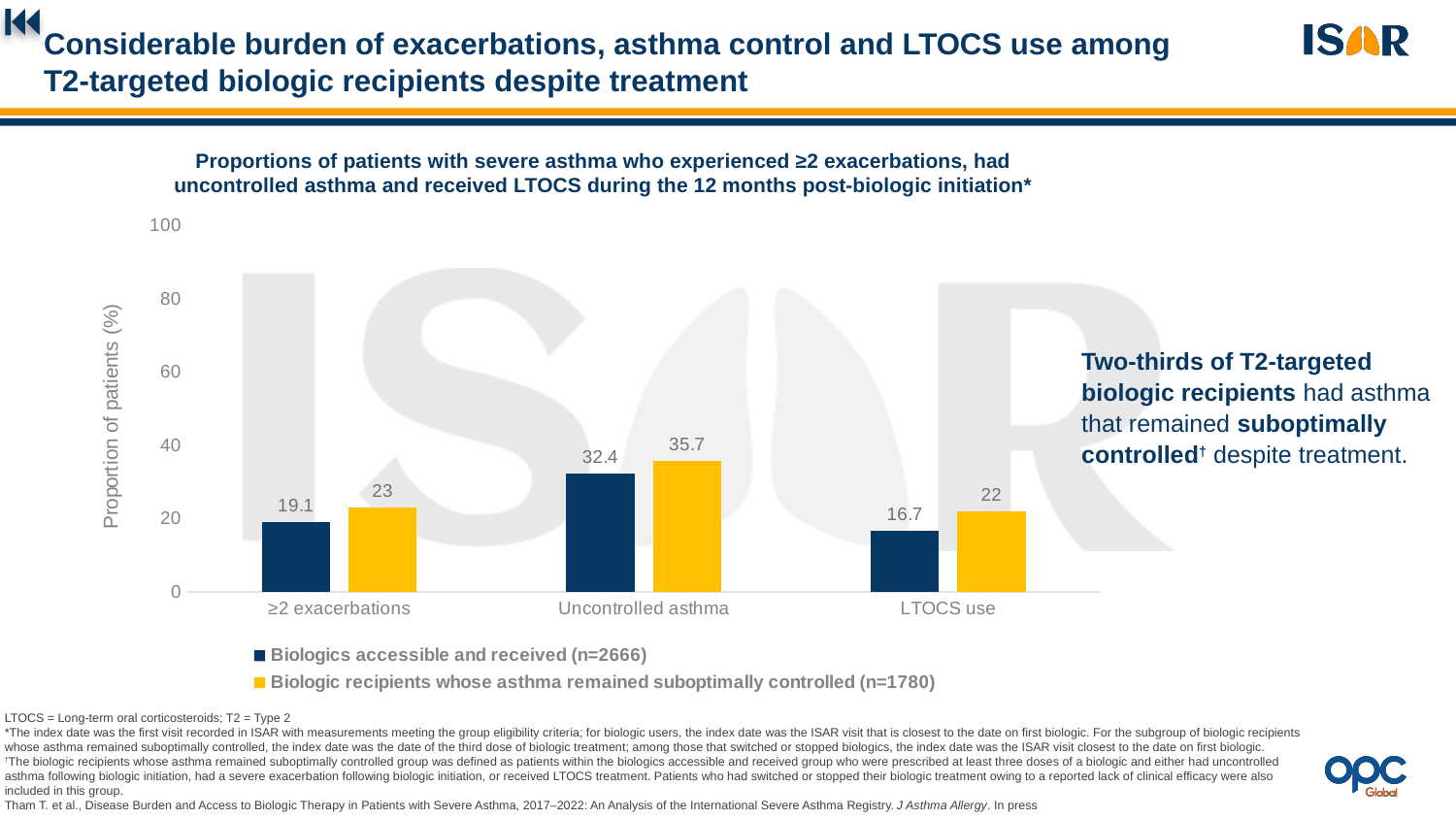
Which category has the highest value in the 'Biologic recipients whose asthma remained suboptimally controlled (n=1780)' series? Uncontrolled asthma How many categories are shown on the x axis? 3 What kind of chart is shown on the slide? Bar chart What is the value for 'LTOCS use' in the 'Biologic recipients whose asthma remained suboptimally controlled (n=1780)' series? 22 What is the difference between the two series for 'LTOCS use'? 5.3 How many series does the legend list? 2 For '≥2 exacerbations', which series has the larger value? Biologic recipients whose asthma remained suboptimally controlled (n=1780) What is the difference between the two series for 'Uncontrolled asthma'? 3.3 What is the value for '≥2 exacerbations' in the 'Biologics accessible and received (n=2666)' series? 19.1 Which category has the lowest value in the 'Biologics accessible and received (n=2666)' series? LTOCS use Is the value for 'Uncontrolled asthma' in the 'Biologic recipients whose asthma remained suboptimally controlled (n=1780)' series greater or less than 40? less What is the value for 'Uncontrolled asthma' in the 'Biologics accessible and received (n=2666)' series? 32.4